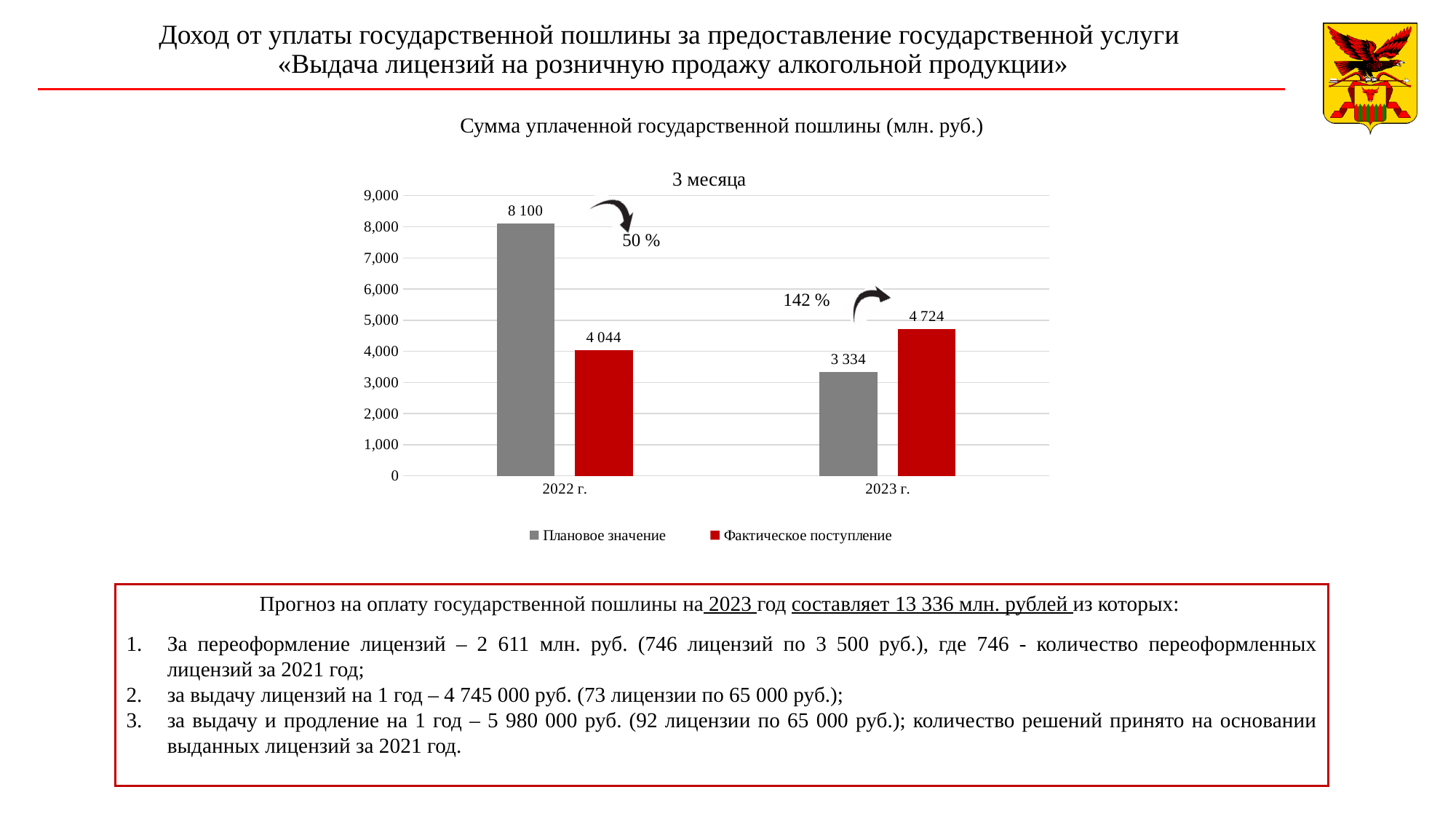
Which bar in the chart has the highest value? Плановое значение, 2022 г. For 2023 г., which is larger: Плановое значение or Фактическое поступление? Фактическое поступление What is the value of Плановое значение for 2022 г.? 8 100 What is the value of Плановое значение for 2023 г.? 3 334 What is the value of Фактическое поступление for 2023 г.? 4 724 Which bar in the chart has the lowest value? Плановое значение, 2023 г. What kind of chart is shown on the slide? Bar chart What is the value of Фактическое поступление for 2022 г.? 4 044 What is the difference between Плановое значение and Фактическое поступление for 2022 г.? 4 056 How many series does the legend list? 2 What is the difference between Фактическое поступление and Плановое значение for 2023 г.? 1 390 What colour are the Фактическое поступление bars? Red